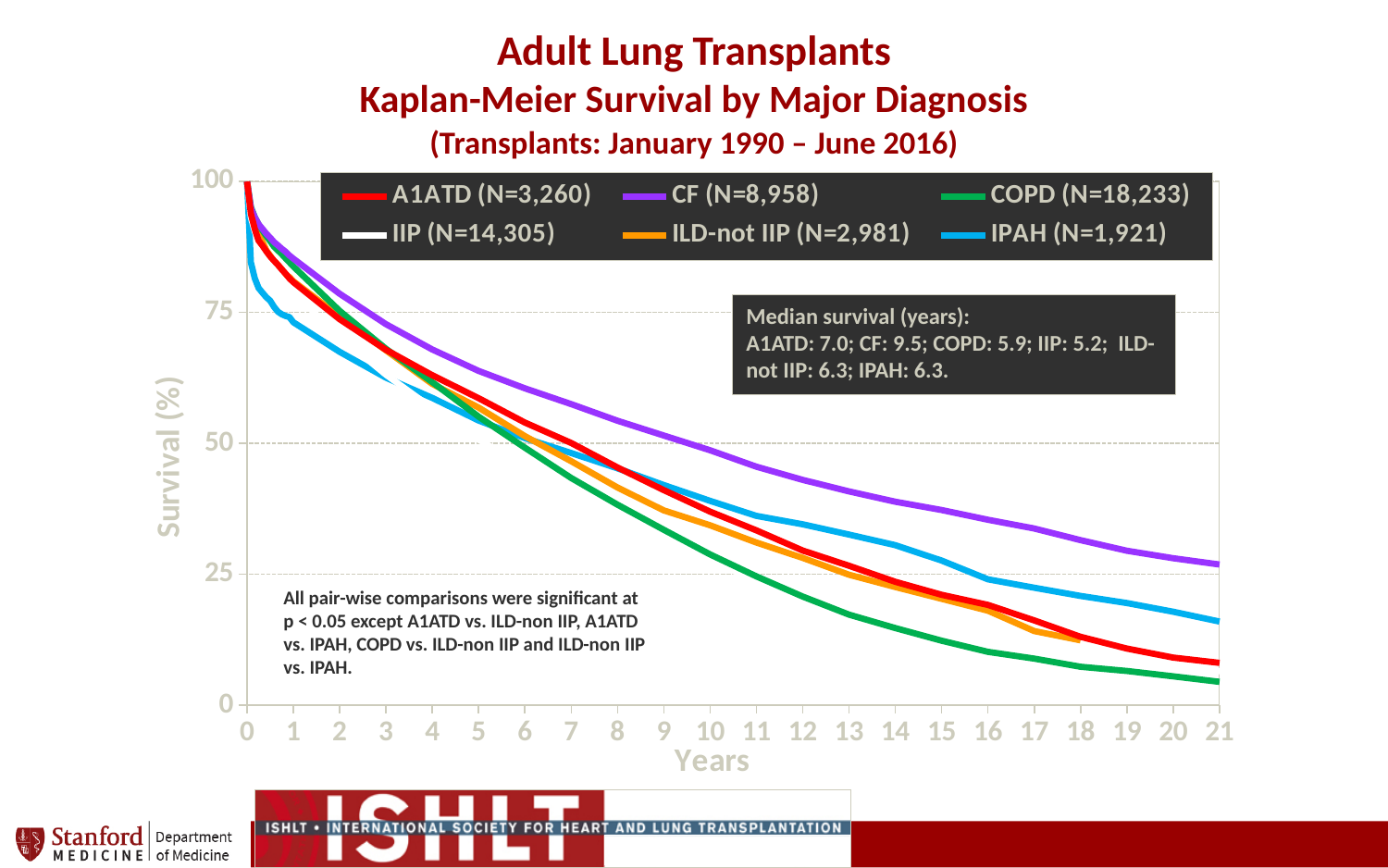
What is the N for the COPD series in the legend? 18,233 What kind of chart is shown on the slide? Line chart How many series does the legend list? 6 Which has a higher median survival, A1ATD or COPD? A1ATD Which diagnosis group has the largest N in the legend? COPD What is the difference in median survival between CF and IIP? 4.3 years Do the survival curves rise or fall as years increase? Fall Which series has the highest survival at 21 years? CF Which diagnosis has the lowest median survival? IIP Is the survival for COPD at 21 years greater or less than 25? less What is the median survival in years for CF? 9.5 Which diagnosis group has the smallest N in the legend? IPAH